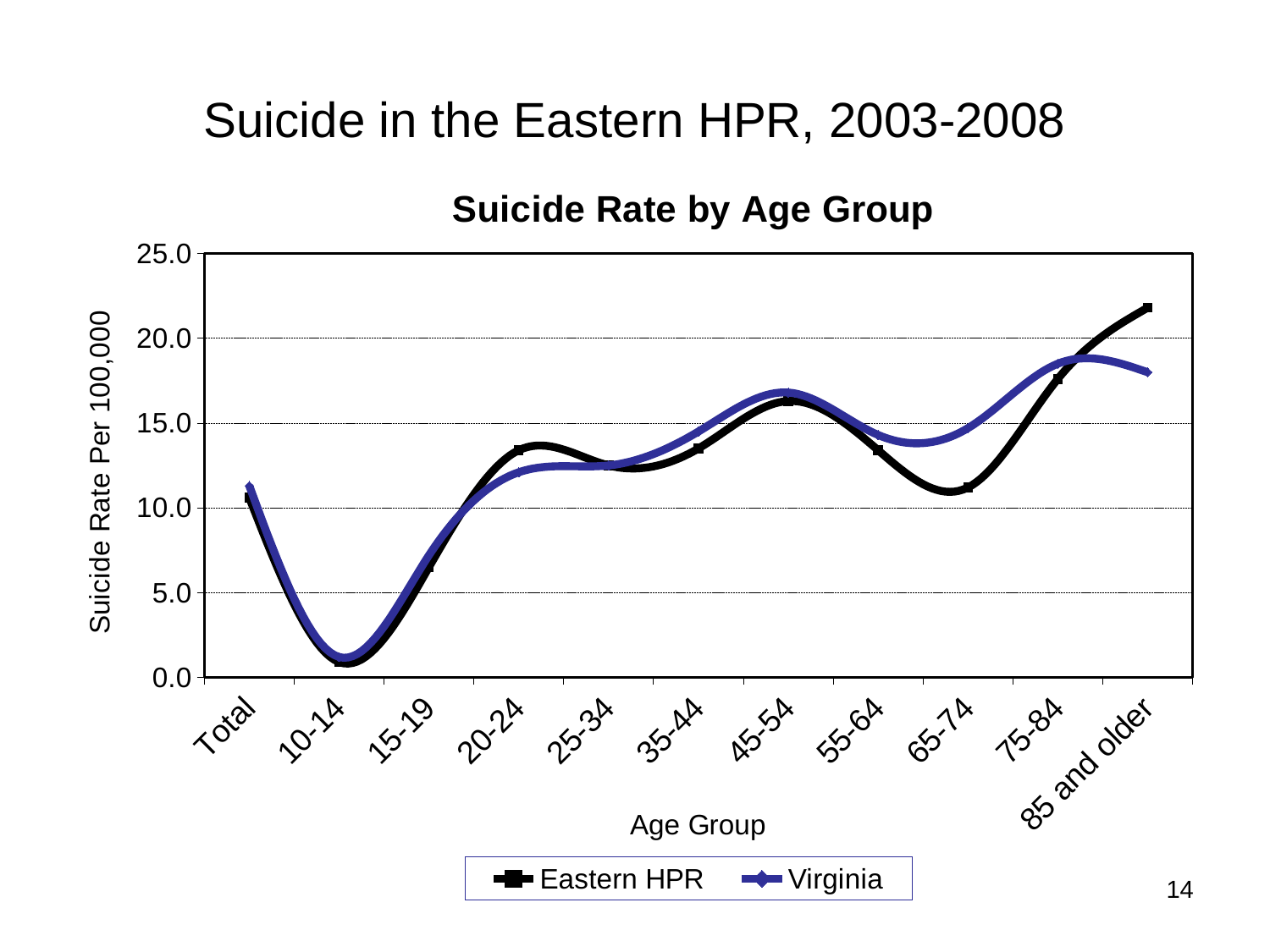
Which age group has the lowest suicide rate for Eastern HPR? 10-14 Is the Virginia value for 85 and older greater or less than 20.0? less Is the Eastern HPR value for 10-14 greater or less than 5.0? less Is the Eastern HPR value for 85 and older greater or less than 20.0? greater Which age group has the highest suicide rate for Eastern HPR? 85 and older For the 65-74 age group, which series has the higher suicide rate, Eastern HPR or Virginia? Virginia For the 85 and older age group, which series has the higher suicide rate, Eastern HPR or Virginia? Eastern HPR How many series does the legend list? 2 How many age group categories are plotted on the x axis? 11 What is the label of the y axis? Suicide Rate Per 100,000 What kind of chart is shown on the slide? line chart